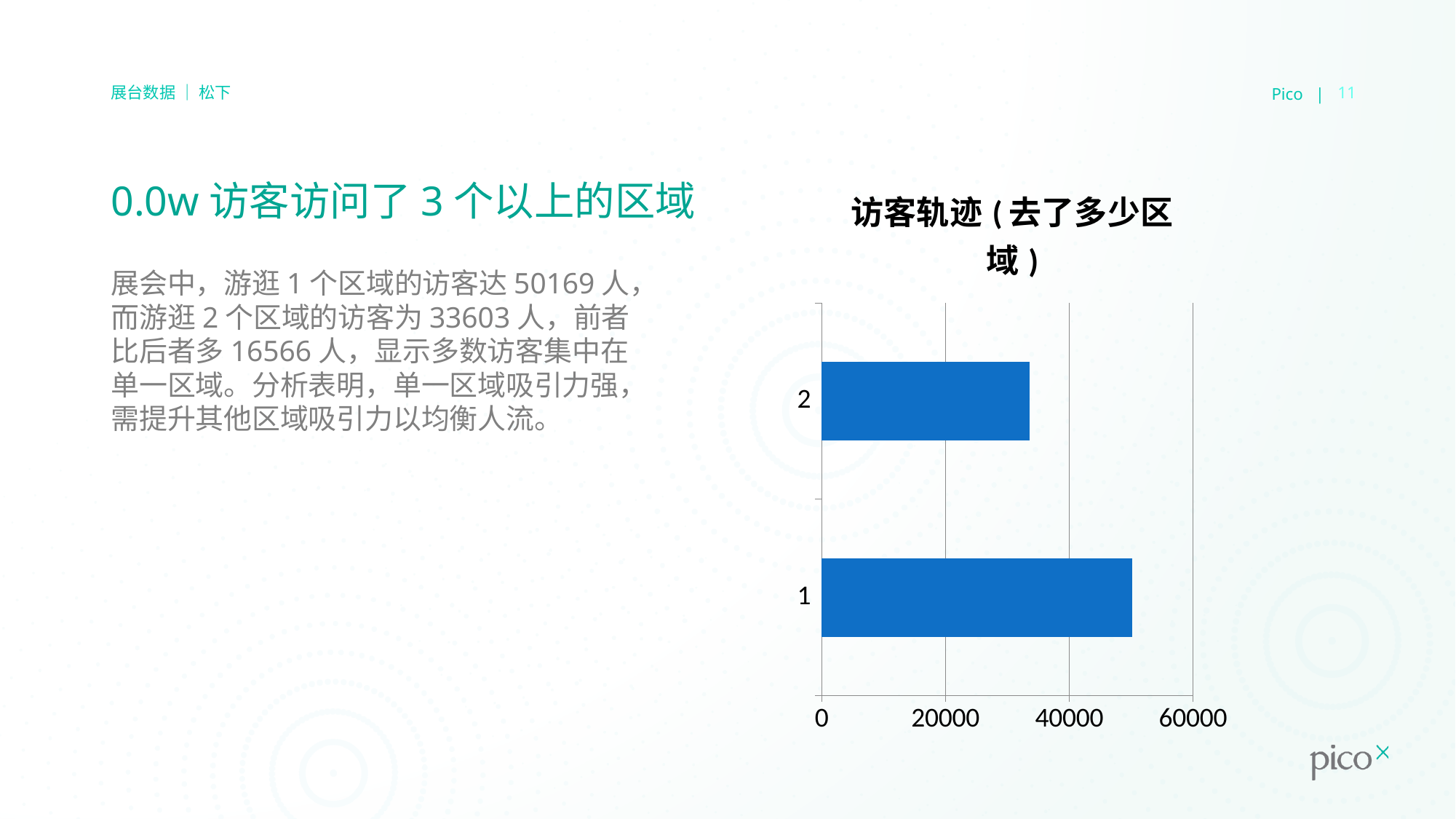
Is the value for category 2 greater or less than 20000? greater What is the highest tick value shown on the chart's horizontal axis? 60000 Which category has the highest value in the chart? 1 Is the value for category 2 greater or less than 40000? less Is the value for category 1 greater or less than 60000? less Which category has the larger value, 1 or 2? 1 What kind of chart is shown on the slide? bar chart Which category has the lowest value in the chart? 2 What is the title of the chart? 访客轨迹（去了多少区域） How many categories are plotted in the chart? 2